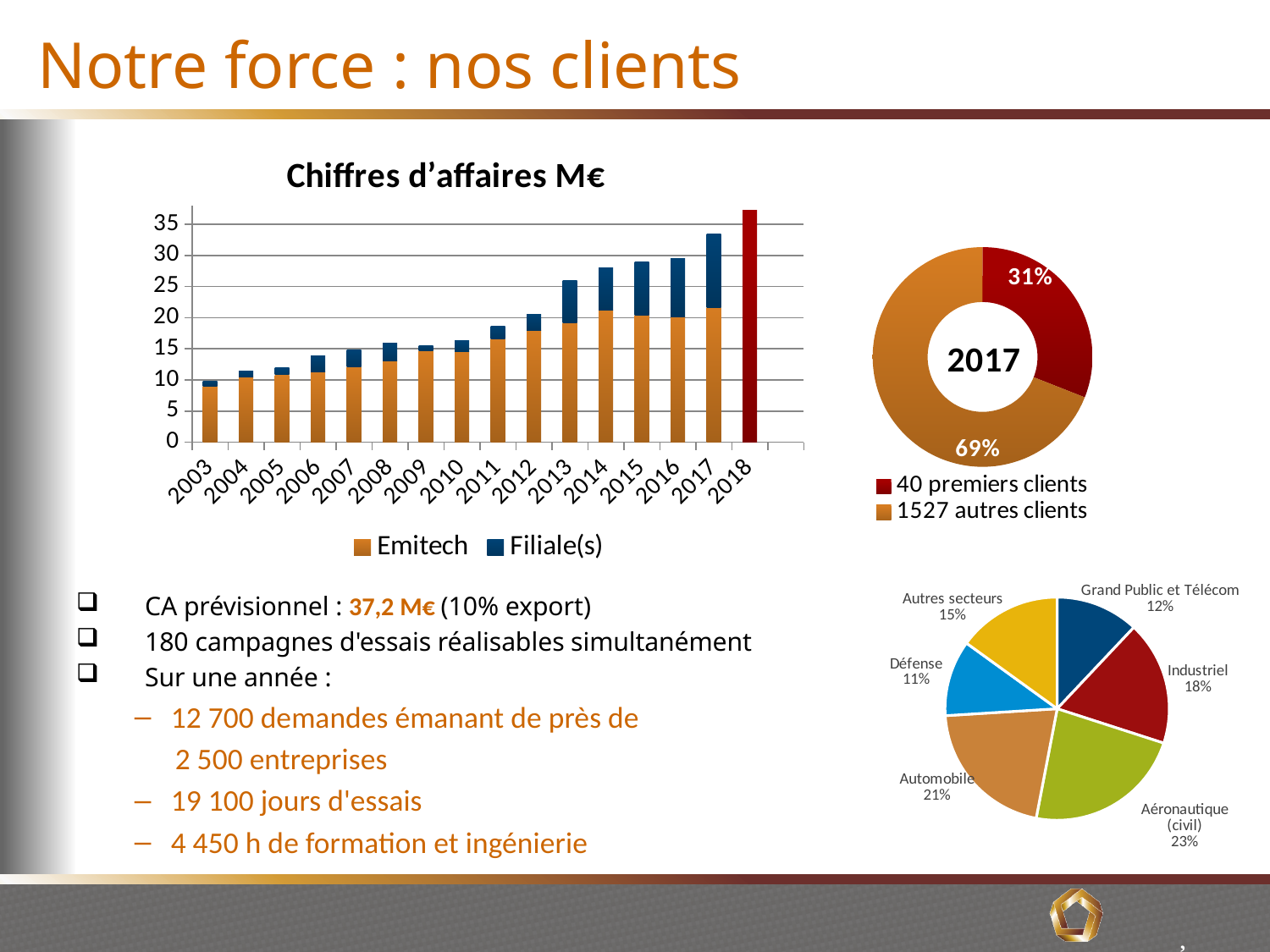
In the donut chart labelled 2017, what share is shown for '40 premiers clients'? 31% In the sector pie chart at the bottom right, what share is shown for Automobile? 21% In the bar chart 'Chiffres d'affaires M€', is the total value for 2017 greater or less than 30? greater In the bar chart 'Chiffres d'affaires M€', is the value for 2018 greater or less than 35? greater In the sector pie chart at the bottom right, which sector has the smallest share? Défense In the bar chart 'Chiffres d'affaires M€', do the total values generally rise or fall from 2003 to 2018? rise In the sector pie chart at the bottom right, which sector has the largest share? Aéronautique (civil) In the donut chart labelled 2017, which is larger: '40 premiers clients' or '1527 autres clients'? 1527 autres clients In the bar chart 'Chiffres d'affaires M€', how many years are shown on the x axis? 16 In the bar chart 'Chiffres d'affaires M€', how many series does the legend list? 2 In the donut chart labelled 2017, what is the difference in percentage points between '1527 autres clients' and '40 premiers clients'? 38